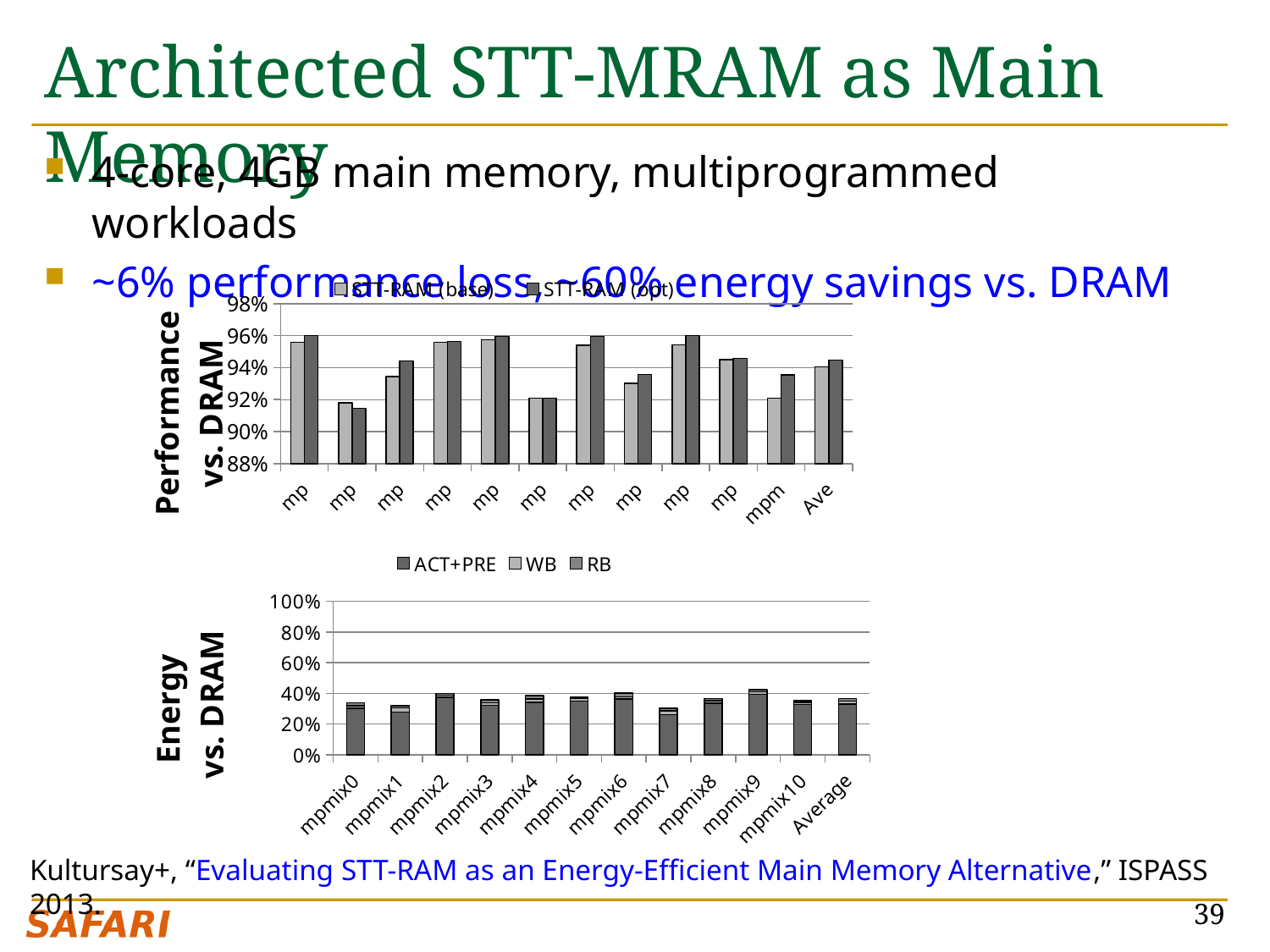
How many series does the legend of the bottom chart (Energy vs. DRAM) list? 3 What kind of chart is the bottom chart (Energy vs. DRAM)? stacked bar chart In the top chart (Performance vs. DRAM), is the STT-RAM (opt) value for Ave greater or less than 92%? greater In the bottom chart (Energy vs. DRAM), which has the larger total stacked bar, mpmix9 or mpmix7? mpmix9 How many series does the legend of the top chart (Performance vs. DRAM) list? 2 In the top chart (Performance vs. DRAM), what are the two series named in the legend? STT-RAM (base) and STT-RAM (opt) What kind of chart is the top chart (Performance vs. DRAM)? bar chart In the bottom chart (Energy vs. DRAM), is the total stacked value for Average greater or less than 60%? less In the top chart (Performance vs. DRAM), is the STT-RAM (base) value for Ave greater or less than 96%? less How many categories are shown on the x axis of the bottom chart (Energy vs. DRAM)? 12 In the bottom chart (Energy vs. DRAM), what are the three series named in the legend? ACT+PRE, WB, RB